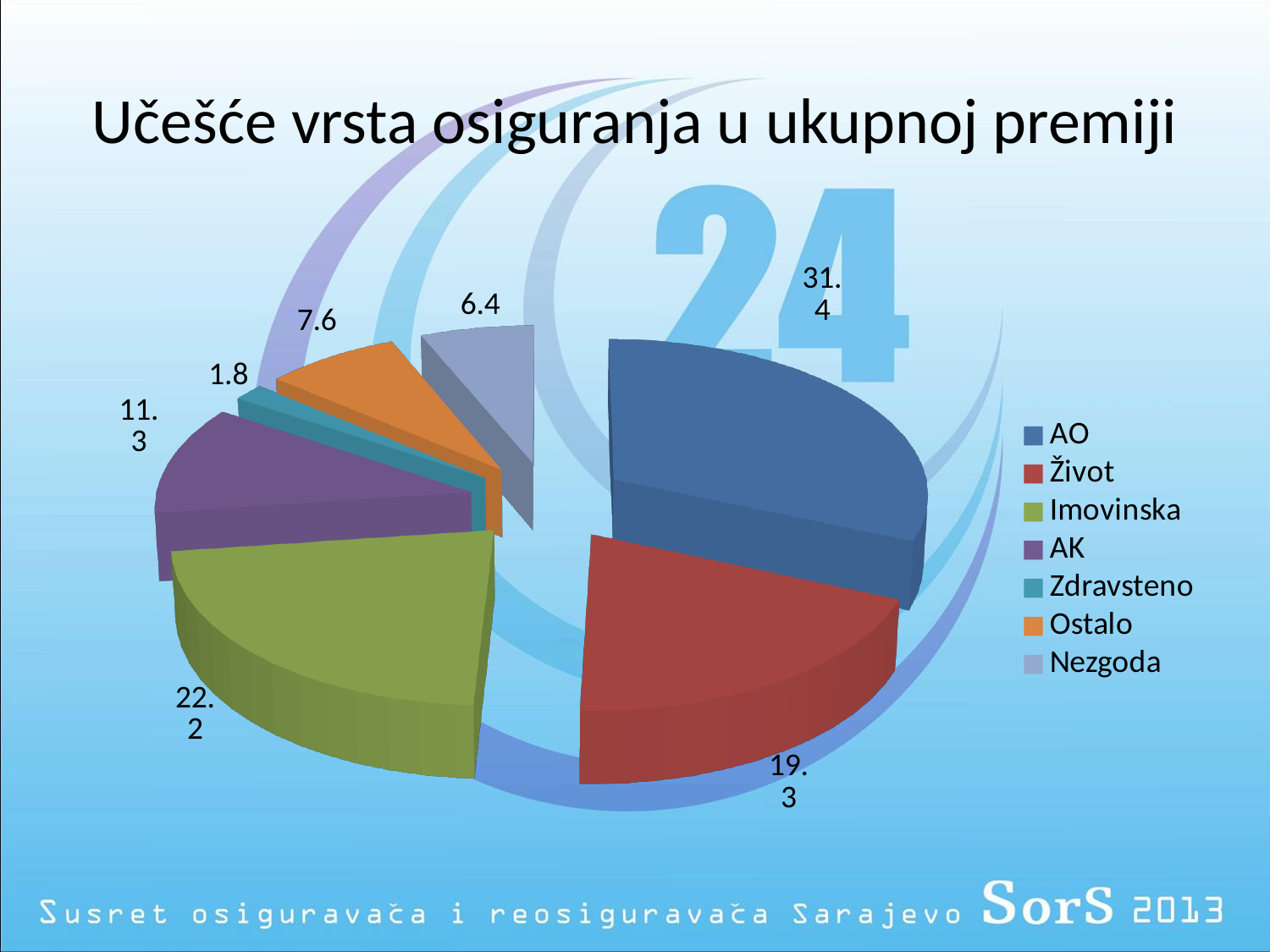
What is the difference between the values for AO and Život? 12.1 What is the value for Život? 19.3 What is the value for Zdravsteno? 1.8 How many categories does the legend list? 7 What is the title of the chart? Učešće vrsta osiguranja u ukupnoj premiji Which colour represents AK in the chart? purple Which category has the largest slice? AO What is the value for Imovinska? 22.2 What is the value for AO? 31.4 What type of chart is shown on the slide? pie chart Which is larger, the value for Ostalo or the value for Nezgoda? Ostalo Which category has the smallest slice? Zdravsteno